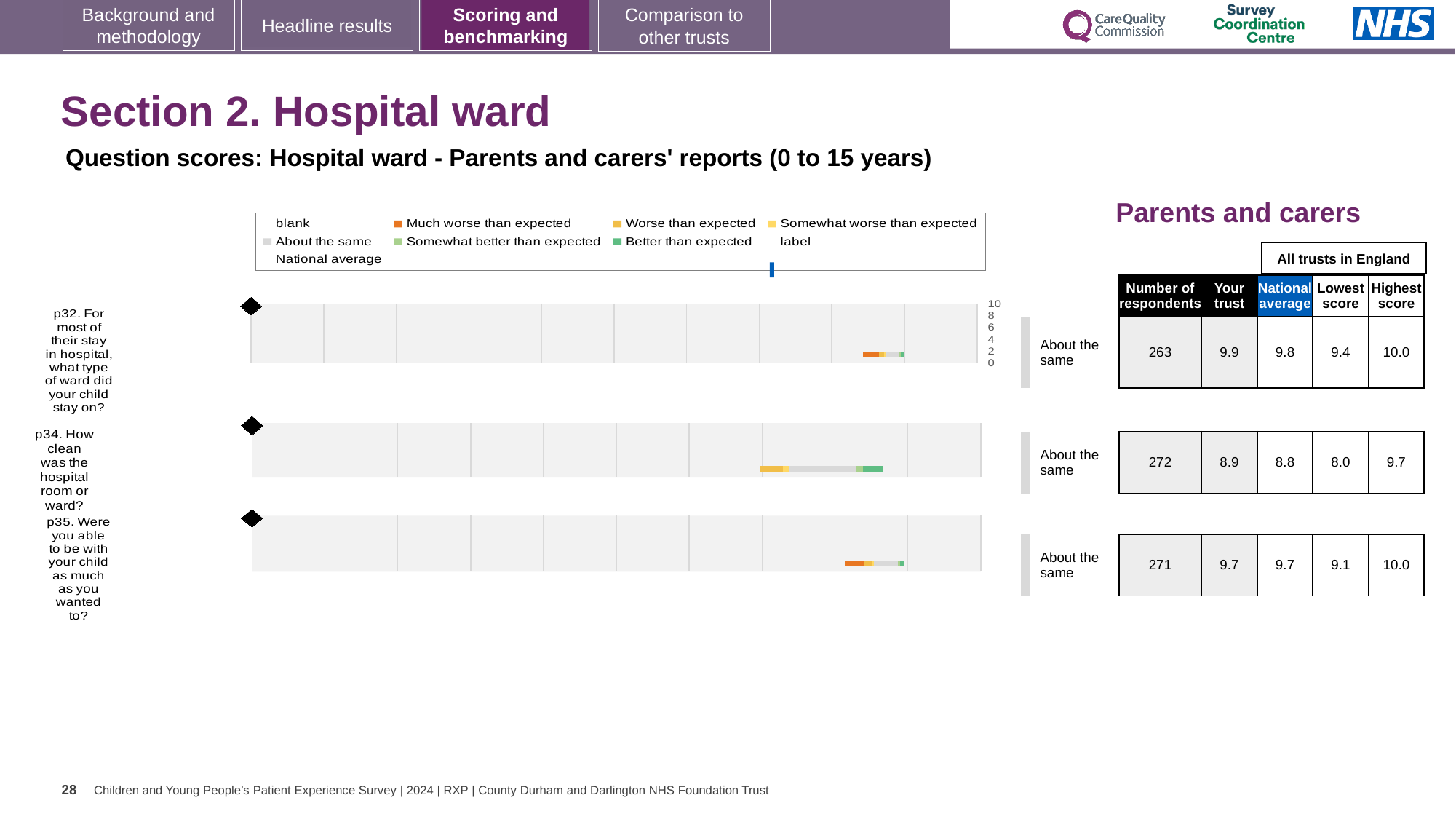
What is the national average score for p35 (Were you able to be with your child as much as you wanted to?)? 9.7 What is the 'Your trust' score for p34 (How clean was the hospital room or ward?)? 8.9 What is the lowest score among all trusts in England for p35? 9.1 How many questions are plotted on this slide? 3 What kind of chart is used to show the question scores on this slide? Bar chart For p32, by how much does the 'Your trust' score exceed the national average? 0.1 For p32, is the 'Your trust' score higher or lower than the national average? higher Which of the three questions has the lowest 'Your trust' score? p34 How many respondents answered p32 (what type of ward did your child stay on)? 263 For p34, what is the difference between the highest score and the lowest score among all trusts in England? 1.7 Which of the three questions has the highest 'Your trust' score? p32 What benchmark category is shown for p34 (How clean was the hospital room or ward?)? About the same